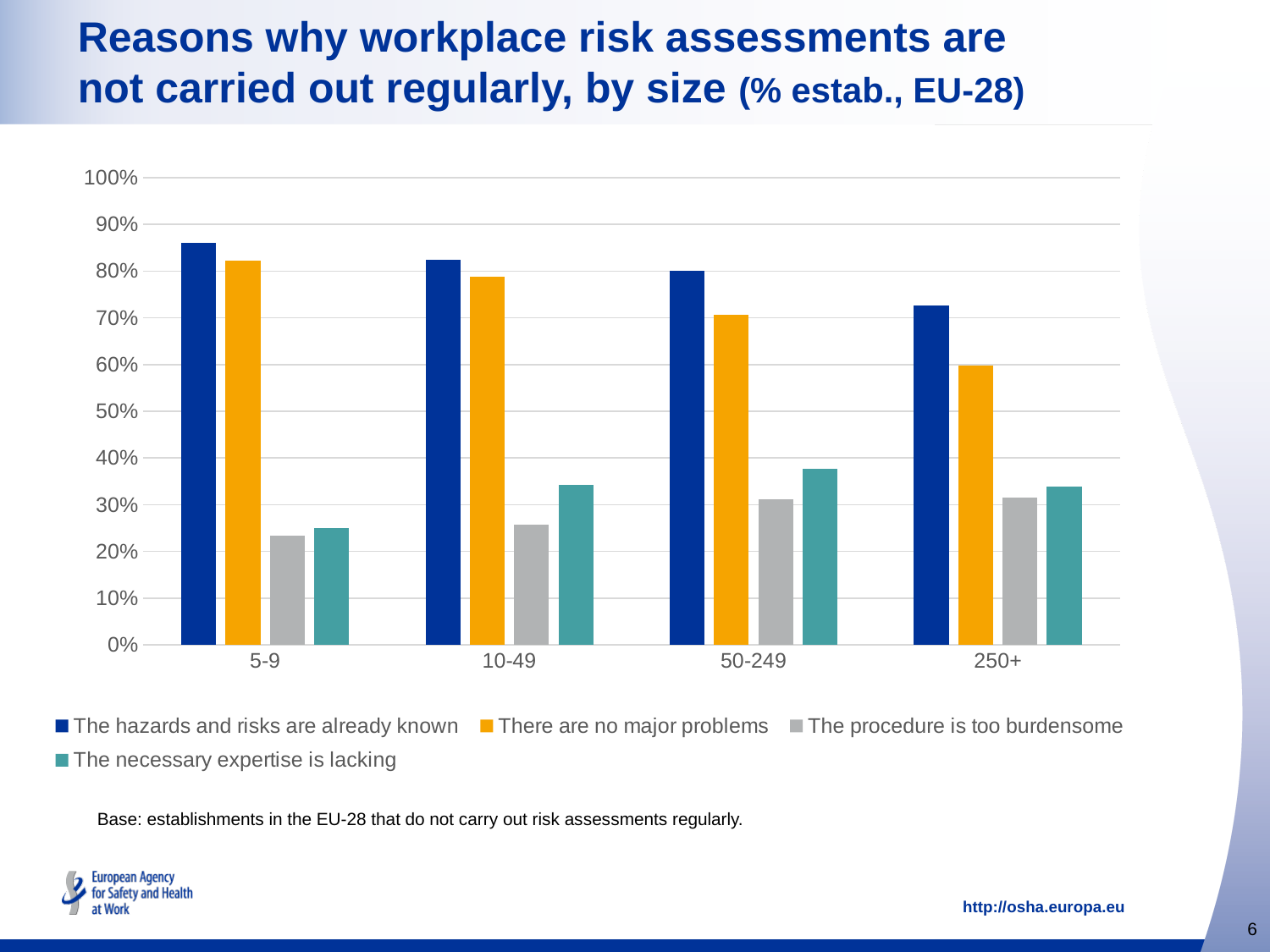
In the 50-249 size category, which is larger: 'The procedure is too burdensome' or 'The necessary expertise is lacking'? The necessary expertise is lacking Is the value for 'The hazards and risks are already known' in the 5-9 size category greater or less than 80%? greater Does the value for 'The hazards and risks are already known' rise or fall as establishment size increases from 5-9 to 250+? fall Is the value for 'The procedure is too burdensome' in the 5-9 size category greater or less than 30%? less What kind of chart is shown on the slide? Bar chart Which size category has the highest value for 'The hazards and risks are already known'? 5-9 Is the value for 'The necessary expertise is lacking' in the 50-249 size category greater or less than 30%? greater How many series does the legend list? 4 What colour represents 'There are no major problems' in the chart? Orange Which size category has the lowest value for 'There are no major problems'? 250+ How many establishment size categories are shown on the x axis? 4